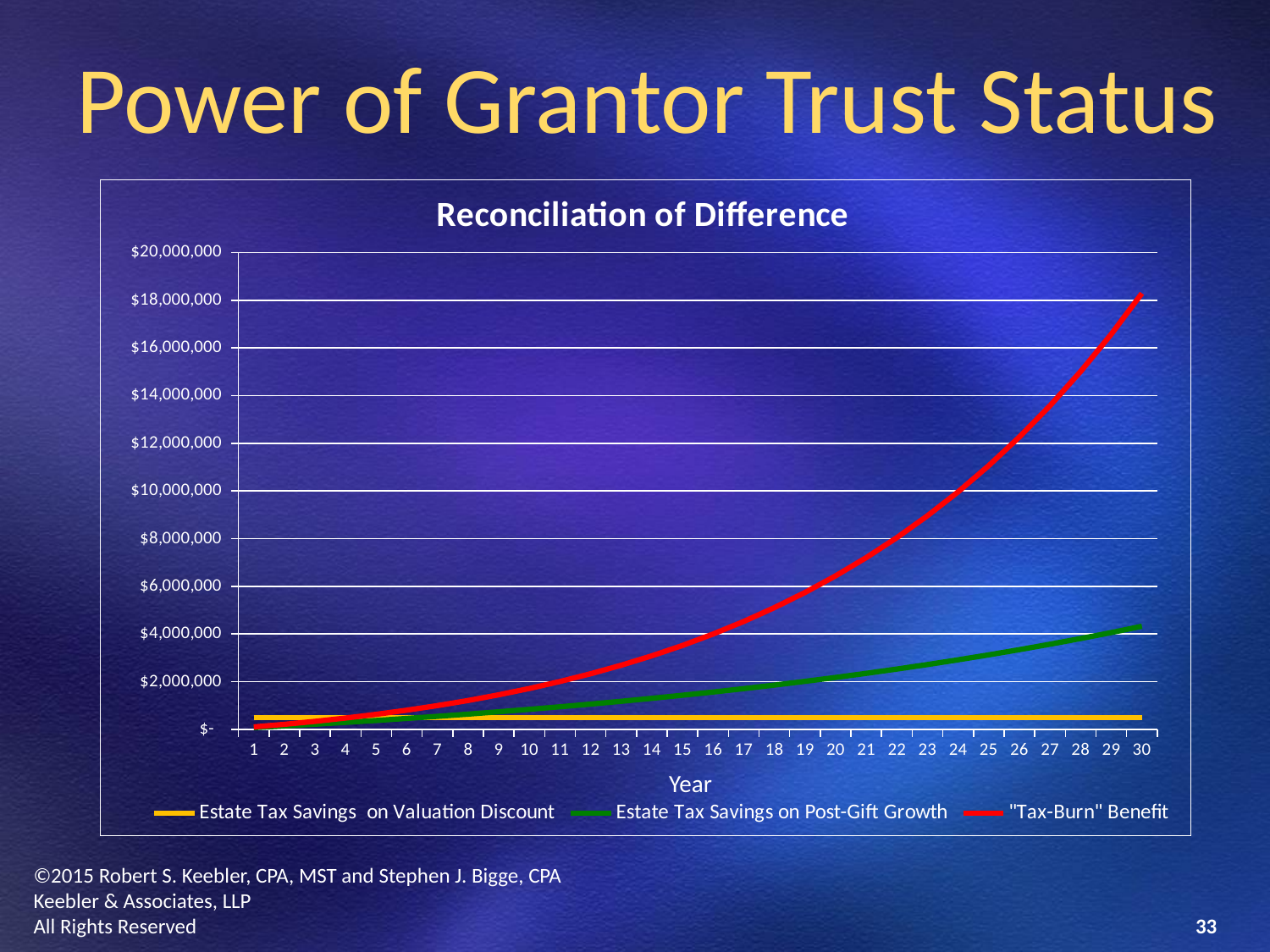
What kind of chart is shown on the slide? line chart Is the Estate Tax Savings on Valuation Discount value at year 15 greater or less than $2,000,000? less What is the title of the chart? Reconciliation of Difference How many years are plotted along the x axis? 30 What is the label of the x axis? Year Is the Estate Tax Savings on Post-Gift Growth value at year 30 greater or less than $6,000,000? less Does the "Tax-Burn" Benefit line rise or fall as the years increase? rise Which series has the highest value at year 30? "Tax-Burn" Benefit At year 30, which is larger: the "Tax-Burn" Benefit or the Estate Tax Savings on Post-Gift Growth? "Tax-Burn" Benefit Is the "Tax-Burn" Benefit value at year 30 greater or less than $16,000,000? greater Which series has the lowest value at year 30? Estate Tax Savings on Valuation Discount How many series does the legend list? 3